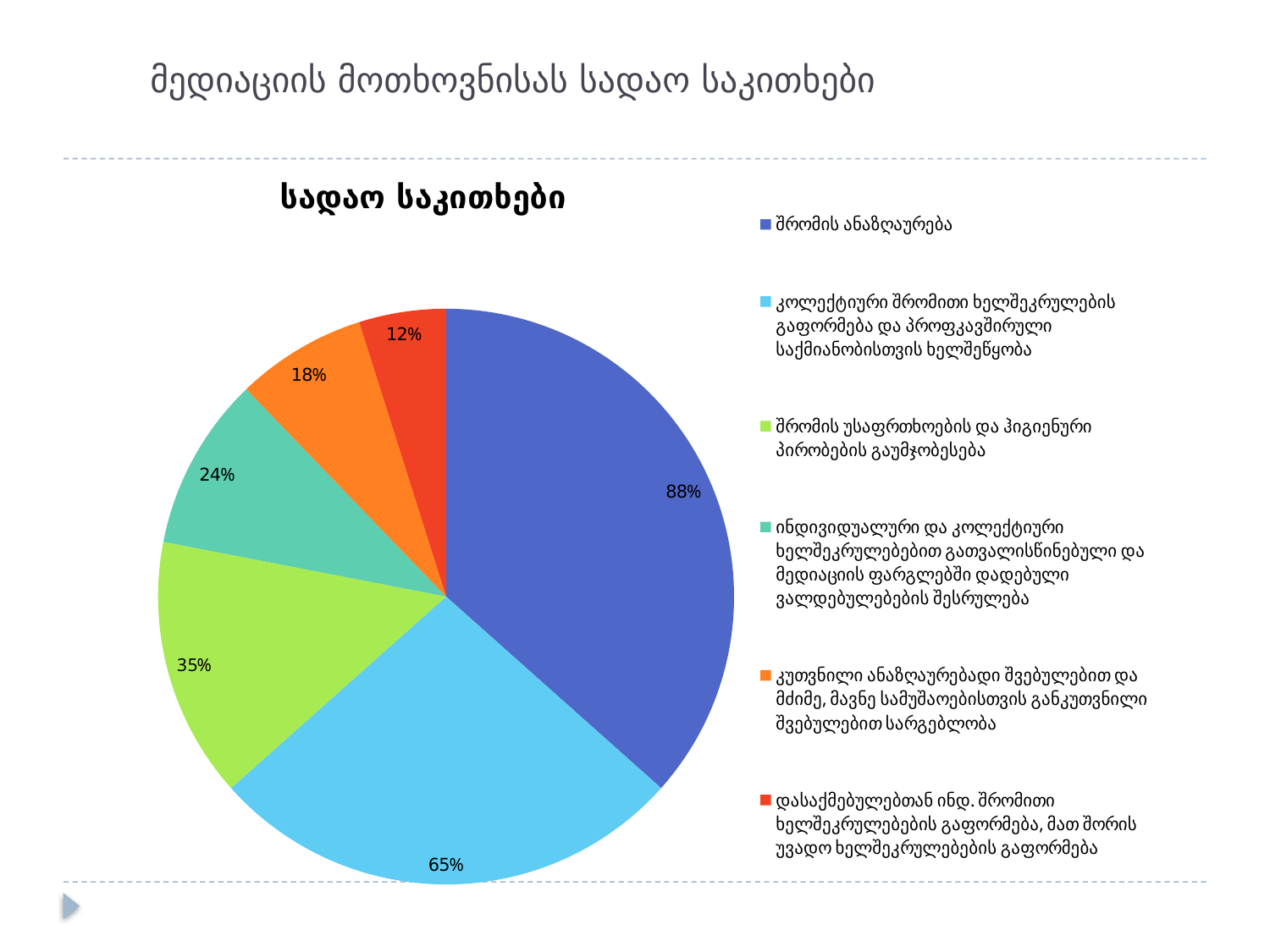
What type of chart is shown on the slide? pie chart What value is labelled on the slice for "შრომის უსაფრთხოების და ჰიგიენური პირობების გაუმჯობესება"? 35% How many slices does the pie chart have? 6 What colour is the slice for "შრომის ანაზღაურება"? blue What is the difference between the labelled values for "შრომის ანაზღაურება" and "კოლექტიური შრომითი ხელშეკრულების გაფორმება და პროფკავშირული საქმიანობისთვის ხელშეწყობა"? 23% How many entries does the legend list? 6 What value is labelled on the slice for "კუთვნილი ანაზღაურებადი შვებულებით და მძიმე, მავნე სამუშაოებისთვის განკუთვნილი შვებულებით სარგებლობა"? 18% Which category has the smallest slice in the pie chart? დასაქმებულებთან ინდ. შრომითი ხელშეკრულებების გაფორმება, მათ შორის უვადო ხელშეკრულებების გაფორმება Which has the larger labelled value: the slice for "შრომის უსაფრთხოების და ჰიგიენური პირობების გაუმჯობესება" or the slice for "ინდივიდუალური და კოლექტიური ხელშეკრულებებით გათვალისწინებული და მედიაციის ფარგლებში დადებული ვალდებულებების შესრულება"? შრომის უსაფრთხოების და ჰიგიენური პირობების გაუმჯობესება What value is labelled on the slice for "შრომის ანაზღაურება"? 88% Which category has the largest slice in the pie chart? შრომის ანაზღაურება What is the title of the chart? სადაო საკითხები